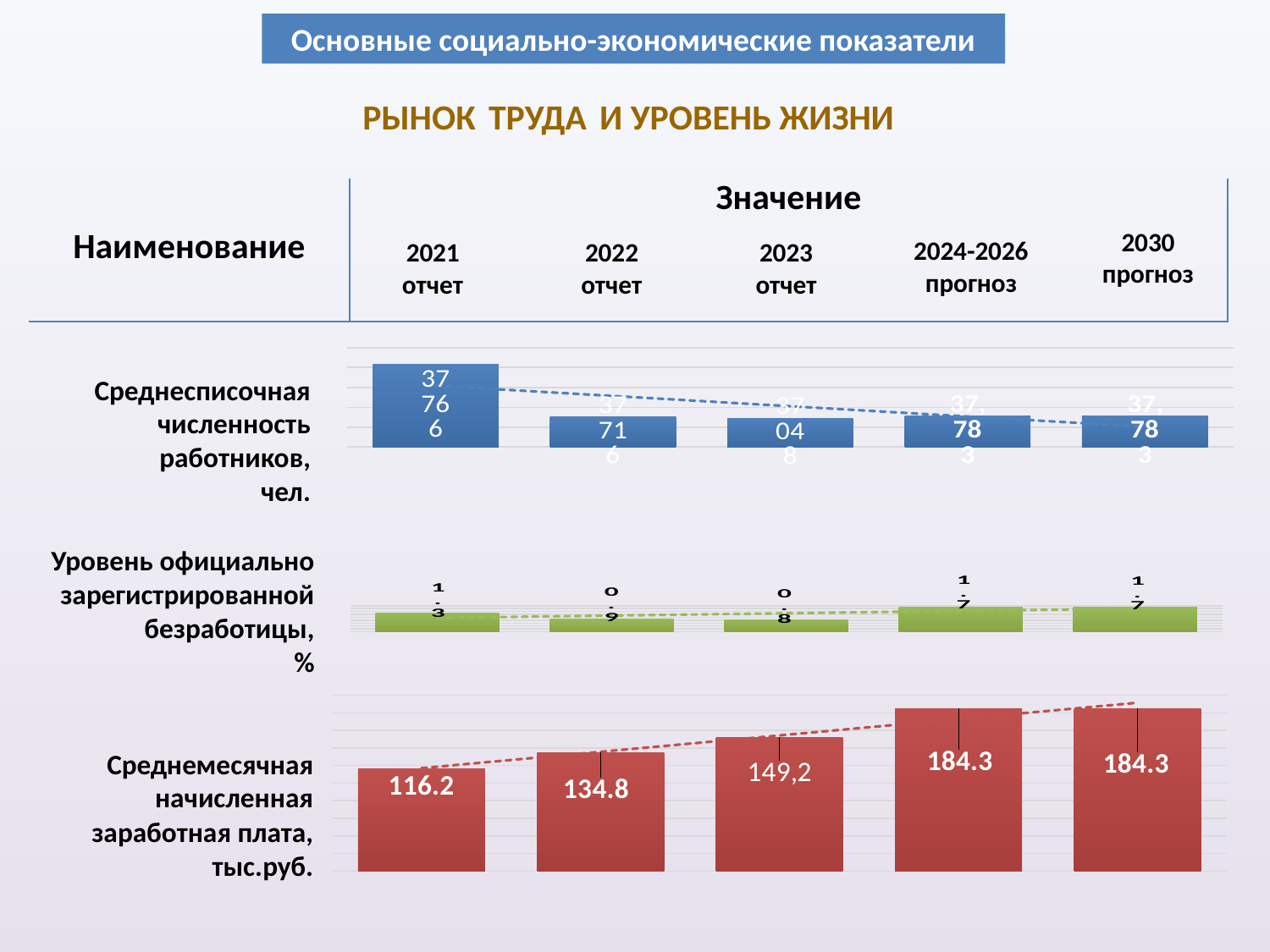
How many periods (bars) are shown in the bottom chart (Среднемесячная начисленная заработная плата, тыс.руб.)? 5 In the bottom chart (Среднемесячная начисленная заработная плата, тыс.руб.), what is the value for 2021 отчет? 116.2 In the bottom chart (Среднемесячная начисленная заработная плата, тыс.руб.), do the values rise or fall from 2021 to 2030? rise In the bottom chart (Среднемесячная начисленная заработная плата, тыс.руб.), what is the value for 2022 отчет? 134.8 In the top chart (Среднесписочная численность работников, чел.), which period has the highest value? 2021 отчет In the bottom chart (Среднемесячная начисленная заработная плата, тыс.руб.), what is the difference between the 2022 and 2021 values? 18.6 In the middle chart (Уровень официально зарегистрированной безработицы, %), what is the value for 2021 отчет? 1.3 What kind of chart is used for Среднемесячная начисленная заработная плата? bar chart What colour are the bars in the bottom chart (Среднемесячная начисленная заработная плата, тыс.руб.)? red In the bottom chart (Среднемесячная начисленная заработная плата, тыс.руб.), what is the value for 2030 прогноз? 184.3 In the bottom chart (Среднемесячная начисленная заработная плата, тыс.руб.), what is the value for 2023 отчет? 149,2 In the bottom chart (Среднемесячная начисленная заработная плата, тыс.руб.), which is larger, the value for 2023 or for 2022? 2023